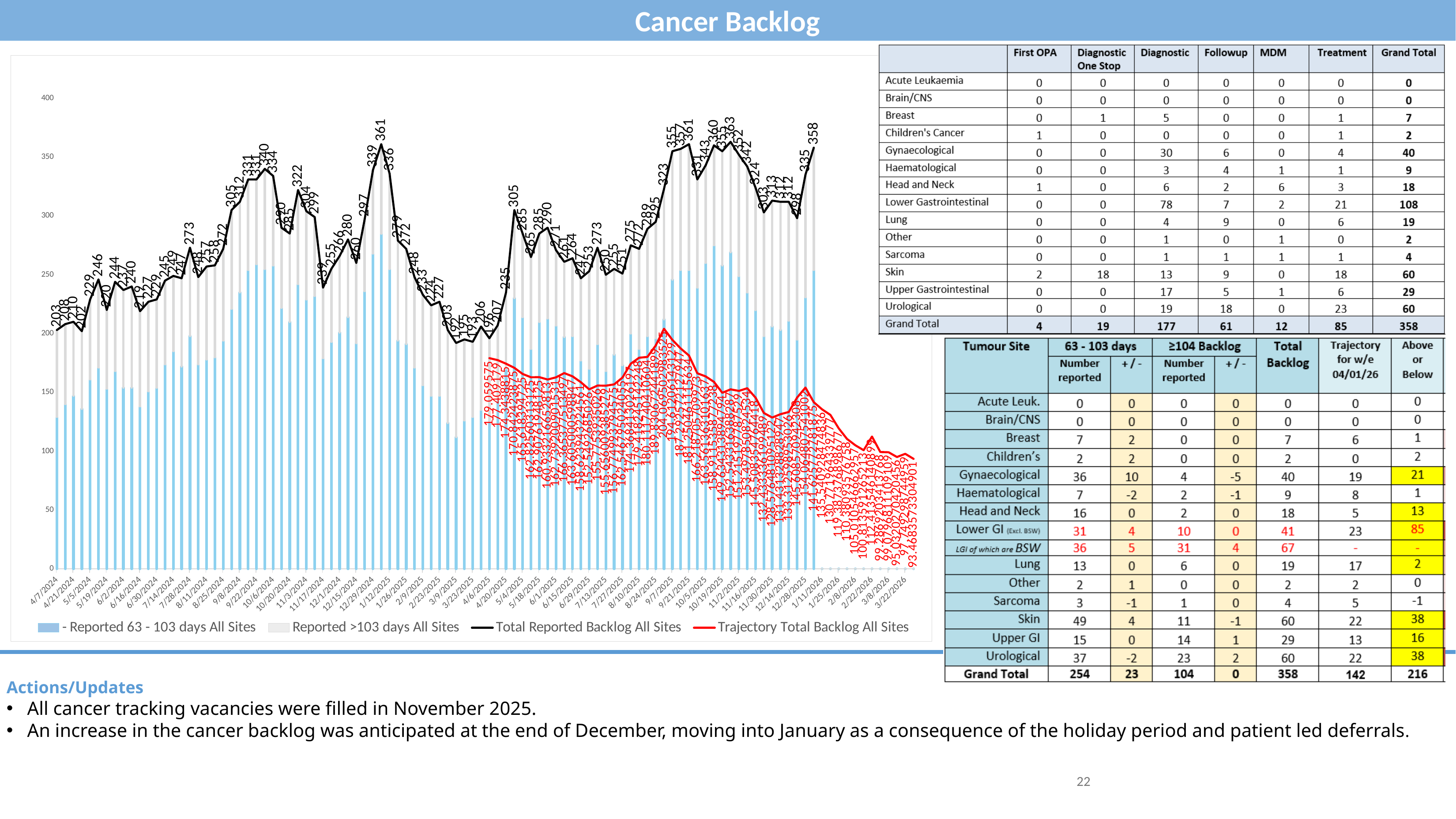
Which is larger: the first labeled value (4/7/2024) or the last labeled value of the Total Reported Backlog All Sites line? The last labeled value (358) What is the first labeled value of the Total Reported Backlog All Sites line, at 4/7/2024? 203 What is the last labeled value of the Total Reported Backlog All Sites line? 358 How many series does the chart legend list? 4 Which series in the chart is drawn as a red line? Trajectory Total Backlog All Sites Does the Trajectory Total Backlog All Sites line rise or fall toward the right end of the x axis? Fall What is the labeled value of the Total Reported Backlog All Sites line at its peak in January 2025? 361 What kind of chart is shown on the slide? A combined bar and line chart Is the Total Reported Backlog All Sites value around 3/9/2025 greater or less than 200? less What colour are the bars for 'Reported 63 - 103 days All Sites'? Blue Is the Trajectory Total Backlog All Sites value at 3/22/2026 greater or less than 150? less What is the difference between the January 2025 peak (361) and the first value (203) of the Total Reported Backlog All Sites line? 158